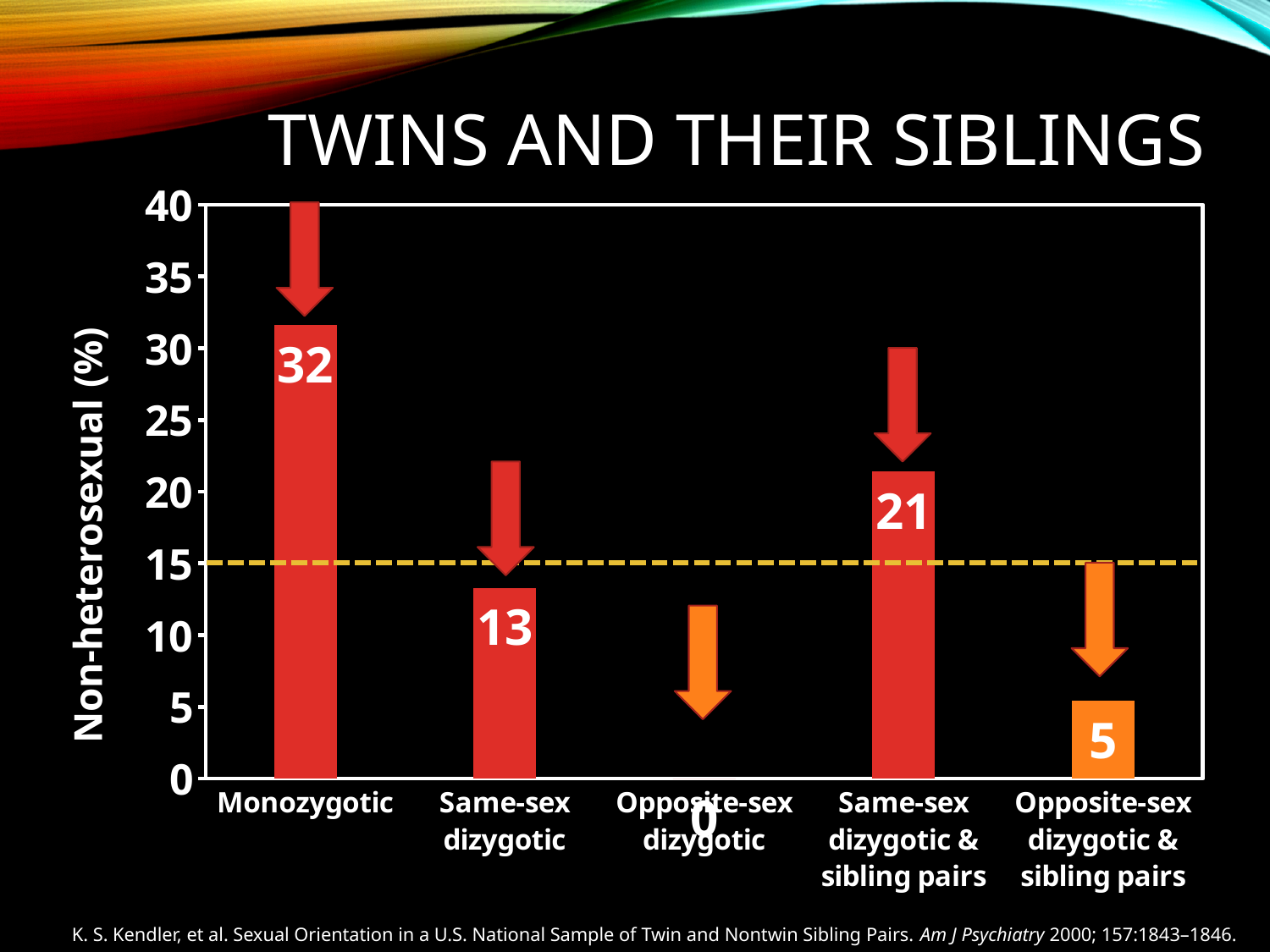
What kind of chart is shown on the slide? bar chart What is the difference between the values for Monozygotic and Same-sex dizygotic? 19 What is the value for Same-sex dizygotic & sibling pairs? 21 Which is larger, the value for Same-sex dizygotic or the value for Same-sex dizygotic & sibling pairs? Same-sex dizygotic & sibling pairs What is the value for Monozygotic? 32 What is the value for Opposite-sex dizygotic & sibling pairs? 5 Which category has the highest value? Monozygotic Which category has the lowest value? Opposite-sex dizygotic Is the value for Same-sex dizygotic greater or less than 15? less What is the value for Opposite-sex dizygotic? 0 What is the label of the y axis? Non-heterosexual (%) How many categories are shown on the x axis? 5